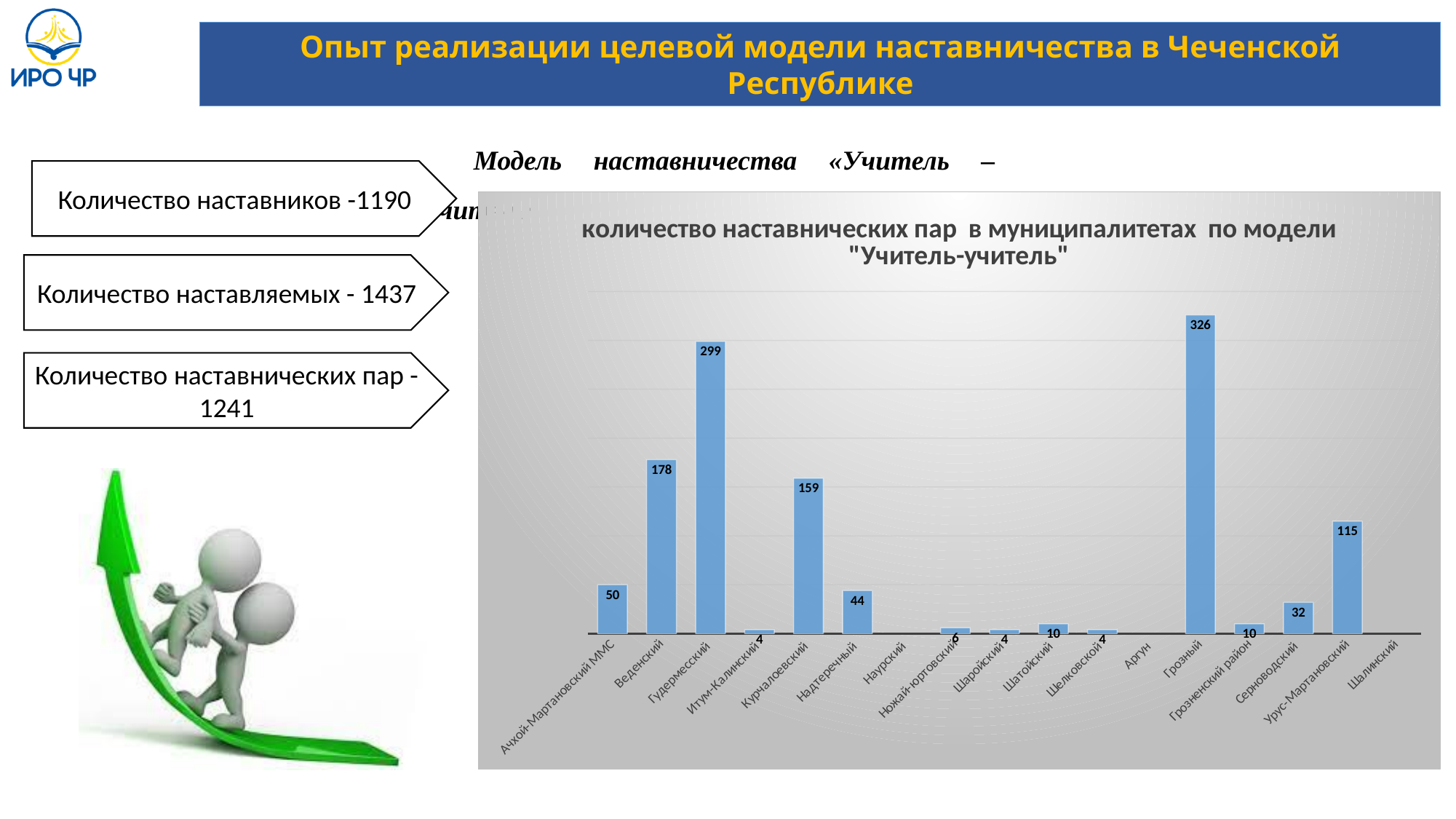
What kind of chart is shown on the slide? bar chart Which is larger, the value for Курчалоевский or the value for Веденский? Веденский What is the title of the chart? количество наставнических пар в муниципалитетах по модели "Учитель-учитель" What is the value for Урус-Мартановский in the chart? 115 What is the value for Веденский in the chart? 178 Which municipality has the highest number of mentoring pairs in the chart? Грозный What is the difference between the values for Грозный and Гудермесский? 27 How many municipalities are listed on the x axis of the chart? 17 What is the value for Гудермесский in the chart? 299 What is the value for Серноводский in the chart? 32 What is the value for Грозный in the chart? 326 What is the difference between the values for Веденский and Курчалоевский? 19